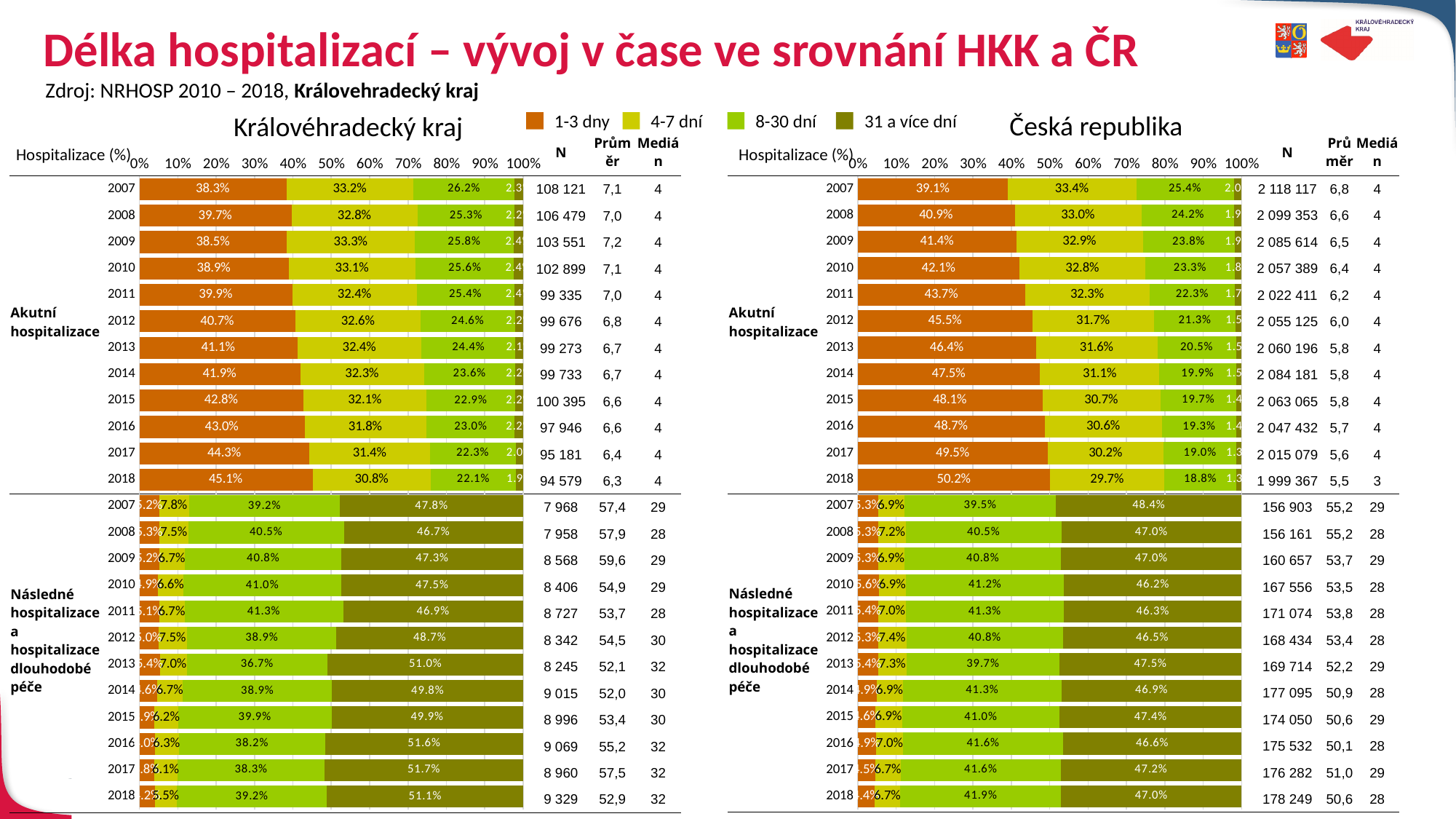
In the Česká republika chart, what is the share of 31 a více dní for Následné hospitalizace in 2007? 48.4% In the Česká republika chart, what is the share of 1-3 dny for Akutní hospitalizace in 2018? 50.2% In the Královéhradecký kraj chart, what is the share of 1-3 dny for Akutní hospitalizace in 2007? 38.3% In the Česká republika chart, does the share of 1-3 dny for Akutní hospitalizace rise or fall from 2007 to 2018? rise In the Královéhradecký kraj chart, what is the share of 8-30 dní for Akutní hospitalizace in 2012? 24.6% In the Královéhradecký kraj chart, what is the share of 31 a více dní for Následné hospitalizace in 2013? 51.0% What kind of chart is used on the slide to show the length of hospitalisations? bar chart In the Česká republika chart, which year has the highest 1-3 dny share for Akutní hospitalizace? 2018 How many years are plotted for Akutní hospitalizace in the Královéhradecký kraj chart? 12 For Akutní hospitalizace in 2018, which chart shows the larger 1-3 dny share, Královéhradecký kraj or Česká republika? Česká republika In the Královéhradecký kraj chart, by how many percentage points does the 1-3 dny share for Akutní hospitalizace in 2018 exceed that in 2007? 6.8 How many series does the legend list? 4